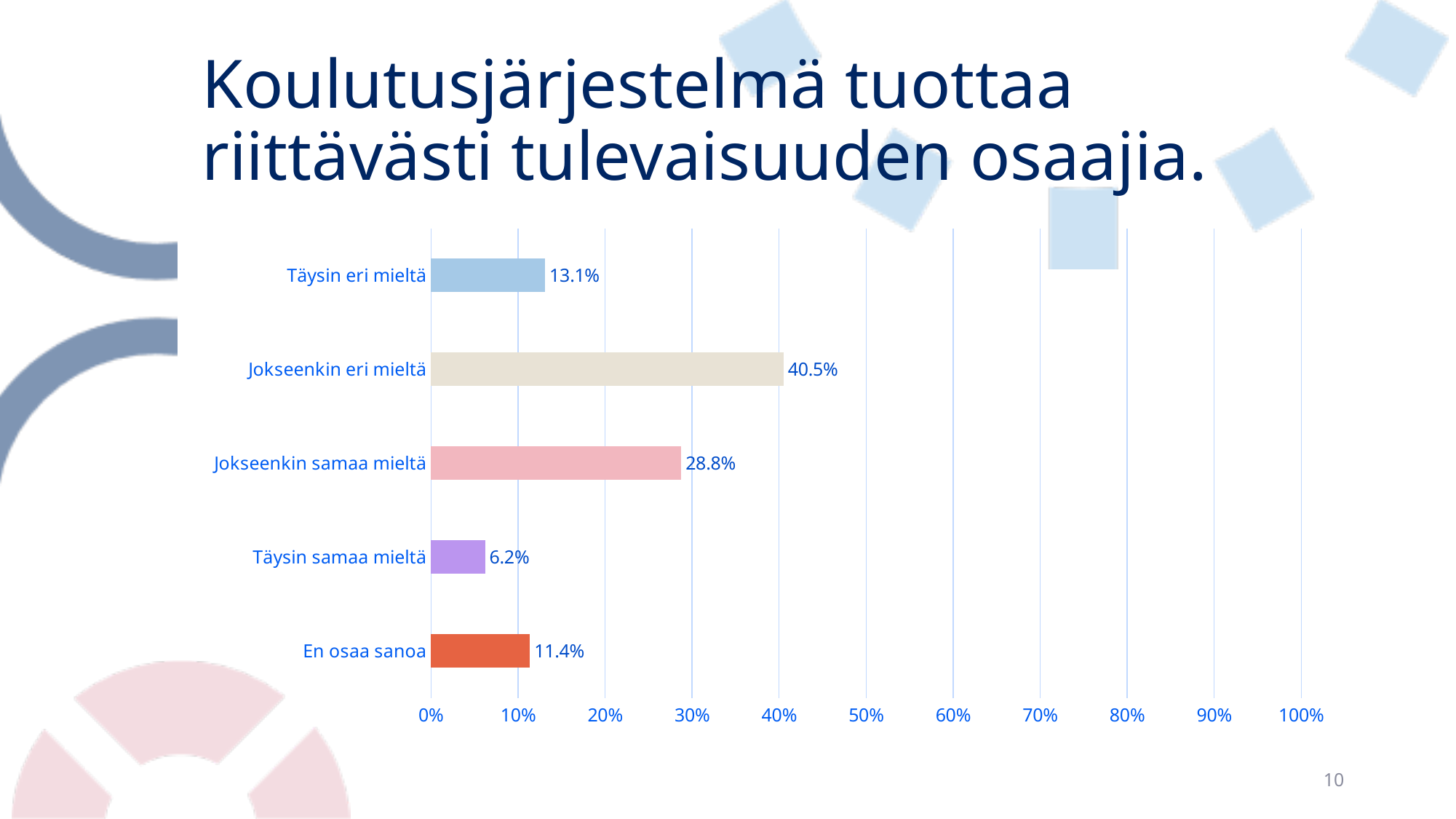
What is the value for En osaa sanoa? 11.4% What is the title of the slide containing the chart? Koulutusjärjestelmä tuottaa riittävästi tulevaisuuden osaajia. Which is larger, the value for Täysin eri mieltä or the value for Täysin samaa mieltä? Täysin eri mieltä How many categories are shown in the chart? 5 Which category has the highest value? Jokseenkin eri mieltä What is the difference between the values for Jokseenkin eri mieltä and Jokseenkin samaa mieltä? 11.7% What kind of chart is shown on the slide? bar chart Is the value for Jokseenkin samaa mieltä greater or less than 30%? less What is the value for Jokseenkin eri mieltä? 40.5% Which category has the lowest value? Täysin samaa mieltä What is the difference between the values for Täysin eri mieltä and En osaa sanoa? 1.7% What is the value for Täysin samaa mieltä? 6.2%